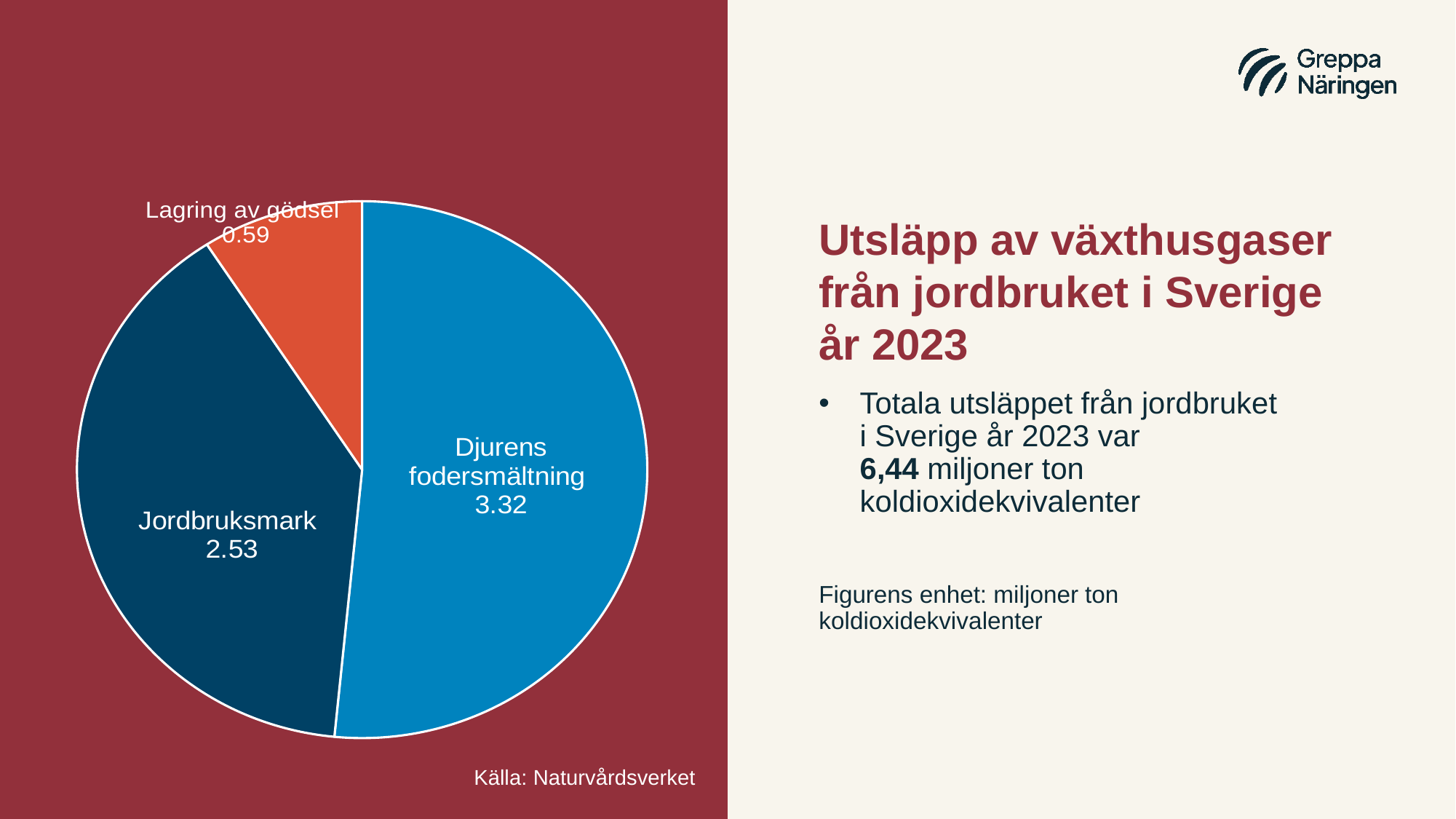
Which category has the largest slice of the pie? Djurens fodersmältning Which is larger, Jordbruksmark or Lagring av gödsel? Jordbruksmark What is the difference between the values for Djurens fodersmältning and Jordbruksmark? 0.79 How many categories are shown in the pie chart? 3 What type of chart is shown on the slide? Pie chart What is the source cited below the chart? Naturvårdsverket What is the total of all slices in the pie chart? 6.44 What is the value for Djurens fodersmältning? 3.32 What is the difference between the values for Jordbruksmark and Lagring av gödsel? 1.94 Which category has the smallest slice of the pie? Lagring av gödsel What is the value for Lagring av gödsel? 0.59 What is the value for Jordbruksmark? 2.53